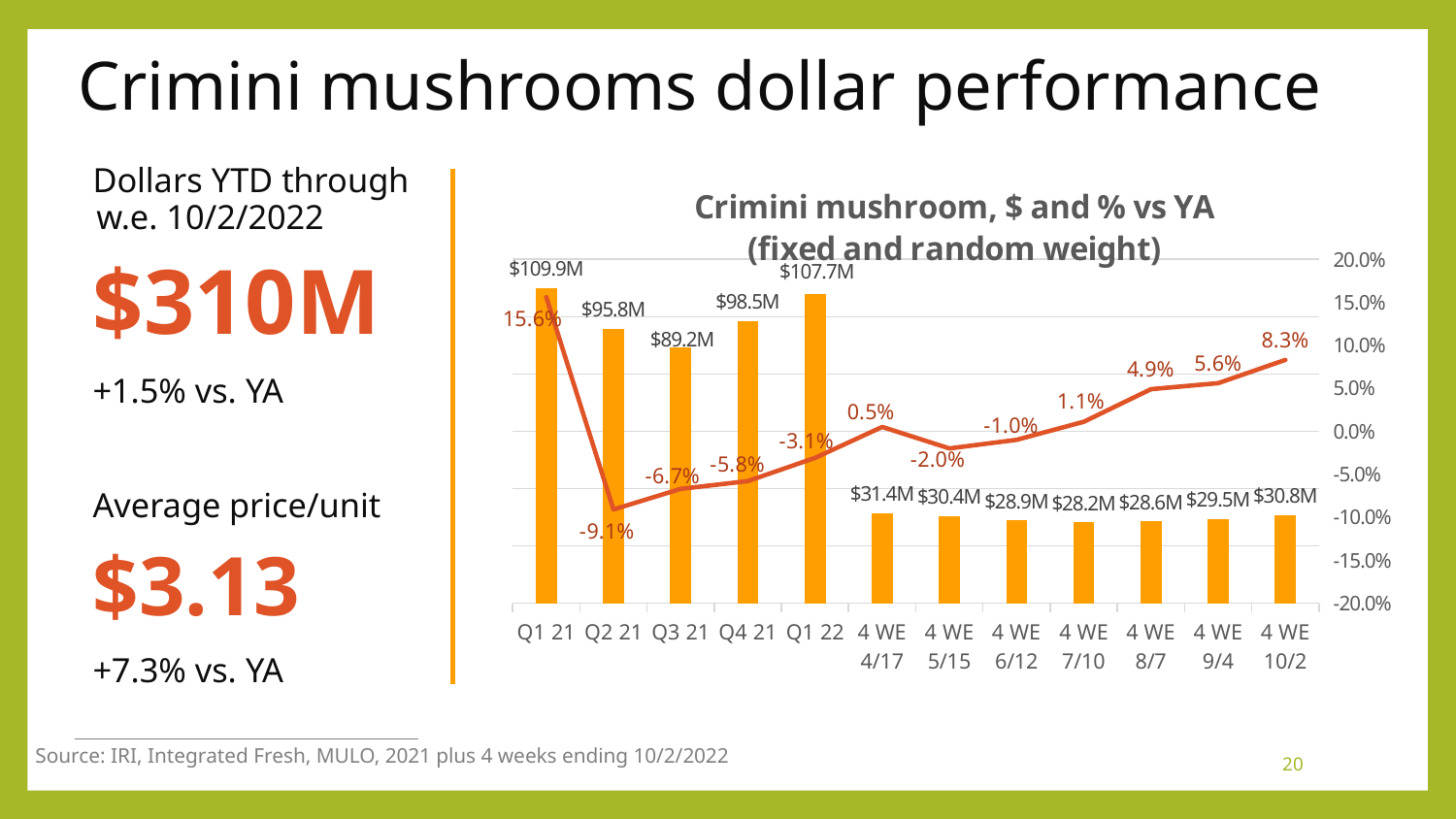
Which is larger, the dollar value for Q2 21 or Q3 21? Q2 21 What is the % vs YA value for Q1 21? 15.6% Which period has the highest dollar value? Q1 21 What is the dollar value for the 4 WE 7/10 period? $28.2M What kind of chart is this? Combination bar and line chart What is the title of the chart? Crimini mushroom, $ and % vs YA (fixed and random weight) How many periods are shown on the x axis? 12 What is the dollar value for Q1 21? $109.9M What is the % vs YA value for the 4 WE 10/2 period? 8.3% What is the difference in dollars between Q1 22 and Q4 21? $9.2M Which period has the lowest % vs YA value? Q2 21 Does the % vs YA line rise or fall from the 4 WE 6/12 period to the 4 WE 10/2 period? Rise